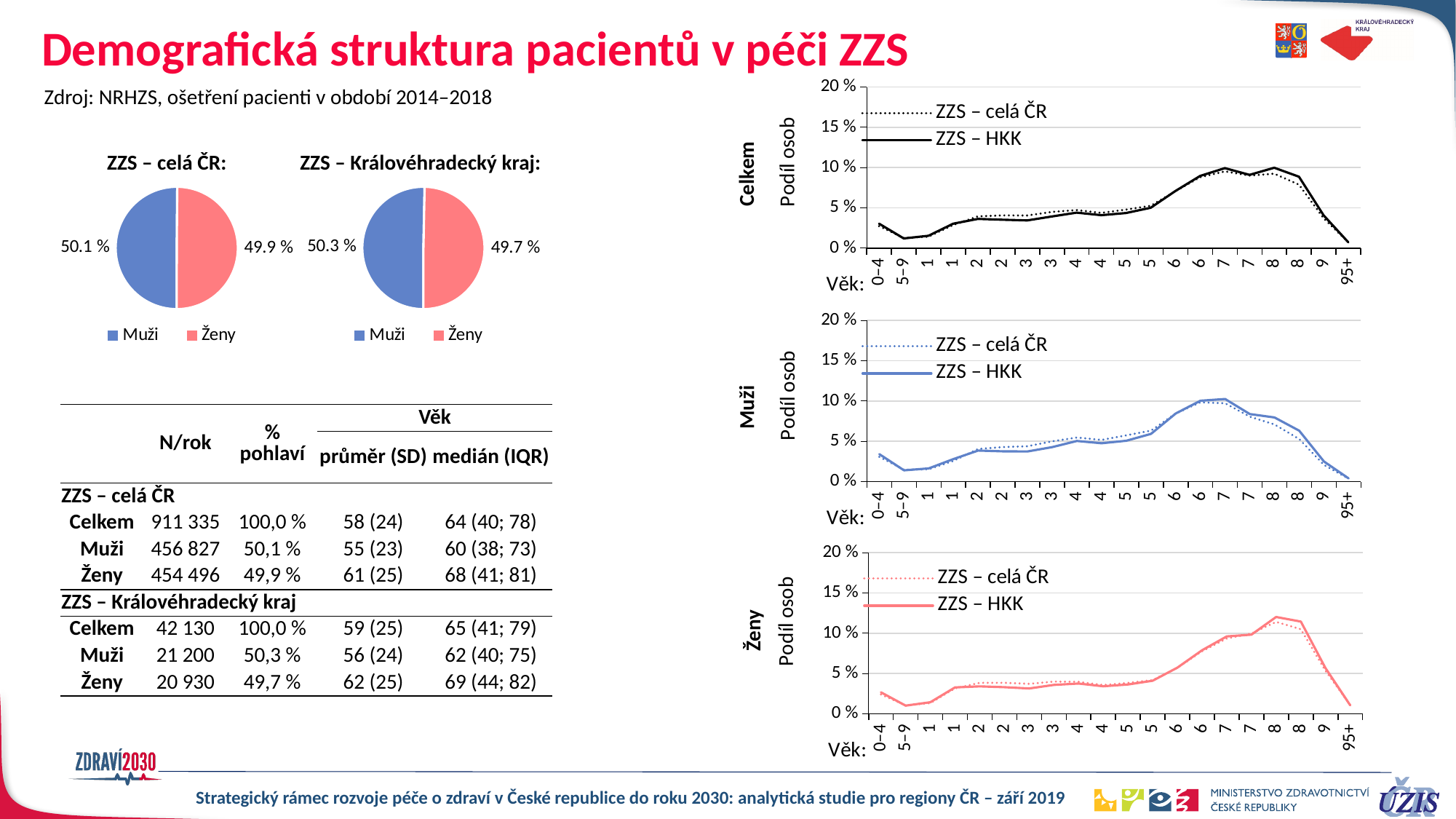
In the pie chart titled "ZZS – Královéhradecký kraj", what share is shown for Ženy? 49.7 % In the "Celkem" line chart, which series is drawn as a dotted line? ZZS – celá ČR How many series does the legend of the "Muži" line chart list? 2 In the "Ženy" line chart, is the peak value of the ZZS – HKK series greater or less than 10 %? greater What kind of chart is the "Celkem" chart on the right of the slide? line chart In the "Celkem" line chart, is the ZZS – HKK value for the 5–9 age group greater or less than 5 %? less In the pie chart titled "ZZS – celá ČR", what share is shown for Muži? 50.1 % In the pie chart titled "ZZS – Královéhradecký kraj", which slice is larger, Muži or Ženy? Muži In the pie chart titled "ZZS – celá ČR", what share is shown for Ženy? 49.9 % What kind of chart is used for the "ZZS – celá ČR" gender breakdown on the left of the slide? pie chart In the pie chart titled "ZZS – Královéhradecký kraj", what share is shown for Muži? 50.3 % In the pie chart titled "ZZS – celá ČR", what is the difference between the Muži and Ženy shares? 0.2 %